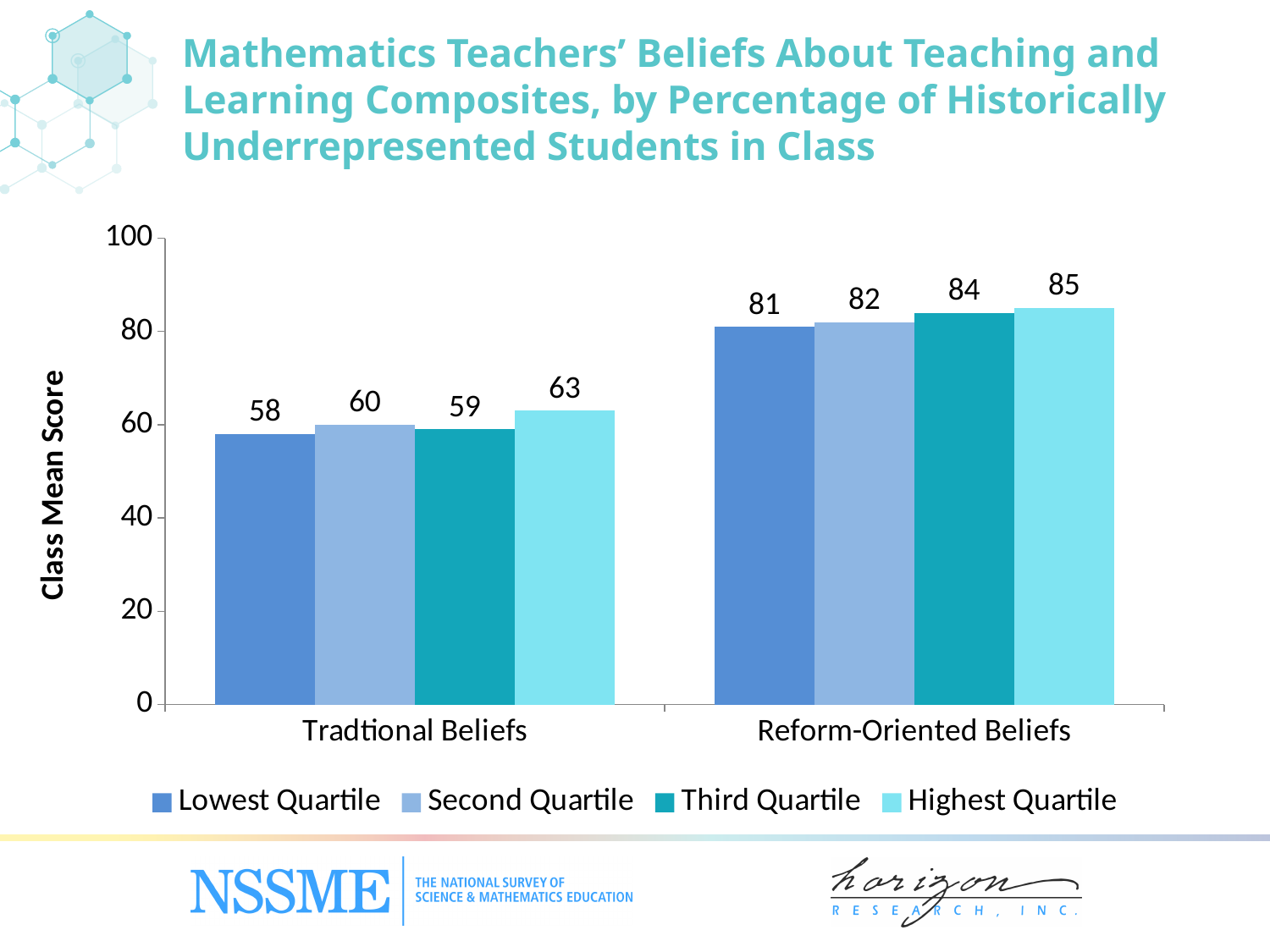
How many categories are shown on the x axis? 2 What is the class mean score for the Third Quartile on Traditional Beliefs? 59 What is the difference between the Highest Quartile and Lowest Quartile scores for Traditional Beliefs? 5 Which quartile has the highest class mean score for Traditional Beliefs? Highest Quartile What is the difference between the Reform-Oriented Beliefs and Traditional Beliefs scores for the Third Quartile? 25 How many series does the legend list? 4 What kind of chart is shown on the slide? Bar chart Which is larger: the Second Quartile score for Traditional Beliefs or the Third Quartile score for Traditional Beliefs? Second Quartile What is the class mean score for the Lowest Quartile on Traditional Beliefs? 58 Which quartile has the lowest class mean score for Reform-Oriented Beliefs? Lowest Quartile What is the class mean score for the Second Quartile on Reform-Oriented Beliefs? 82 What is the class mean score for the Highest Quartile on Reform-Oriented Beliefs? 85